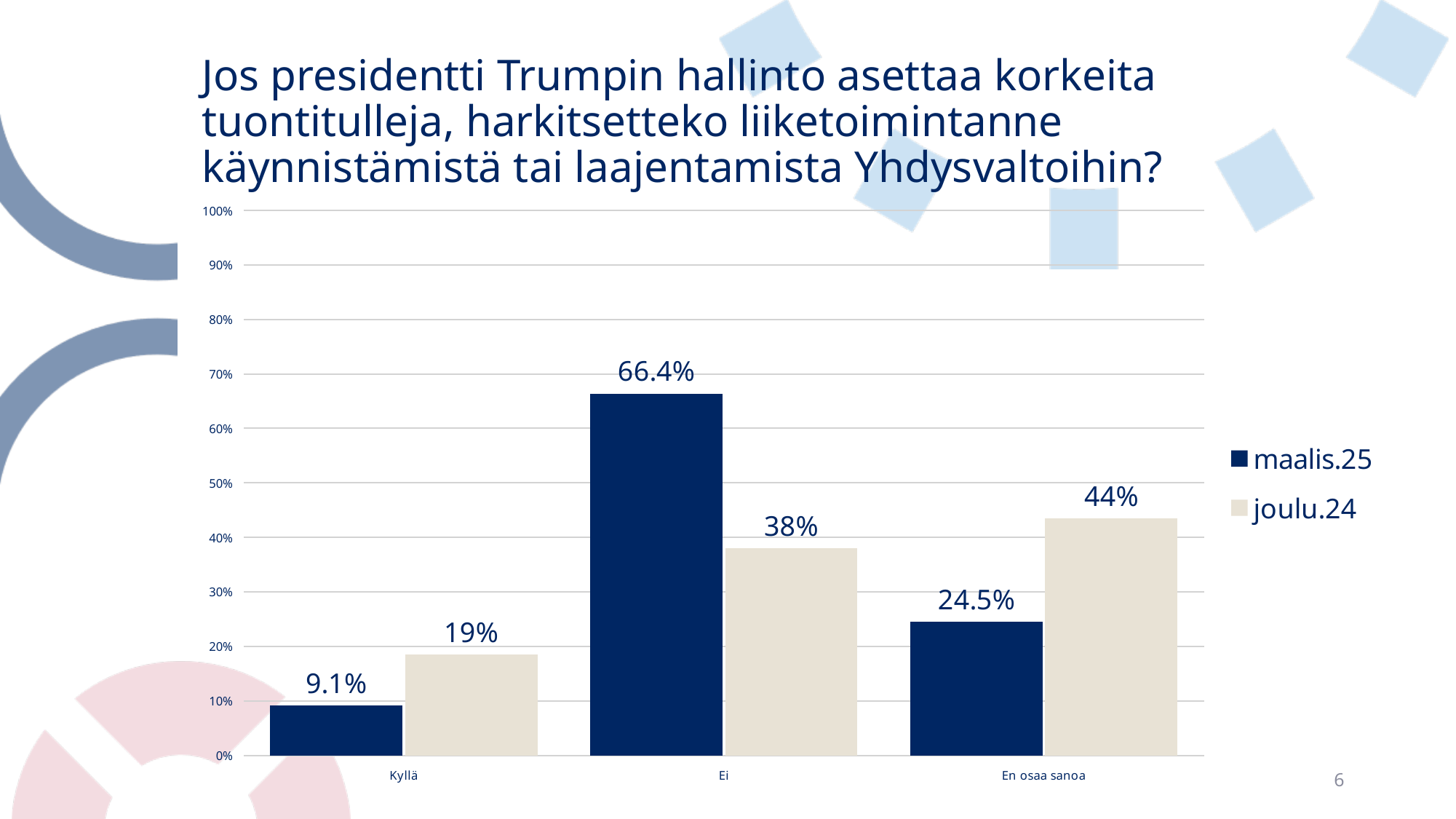
Which category has the highest value in the maalis.25 series? Ei Which series is shown in dark blue? maalis.25 What is the value for Kyllä in the maalis.25 series? 9.1% What is the difference between the maalis.25 and joulu.24 values for Ei? 28.4% What is the value for En osaa sanoa in the maalis.25 series? 24.5% Which category has the lowest value in the joulu.24 series? Kyllä How many categories are shown on the x axis? 3 What kind of chart is shown on the slide? Bar chart Which is larger for En osaa sanoa: the maalis.25 value or the joulu.24 value? joulu.24 How many series does the legend list? 2 What is the value for Ei in the joulu.24 series? 38% What is the value for Kyllä in the joulu.24 series? 19%